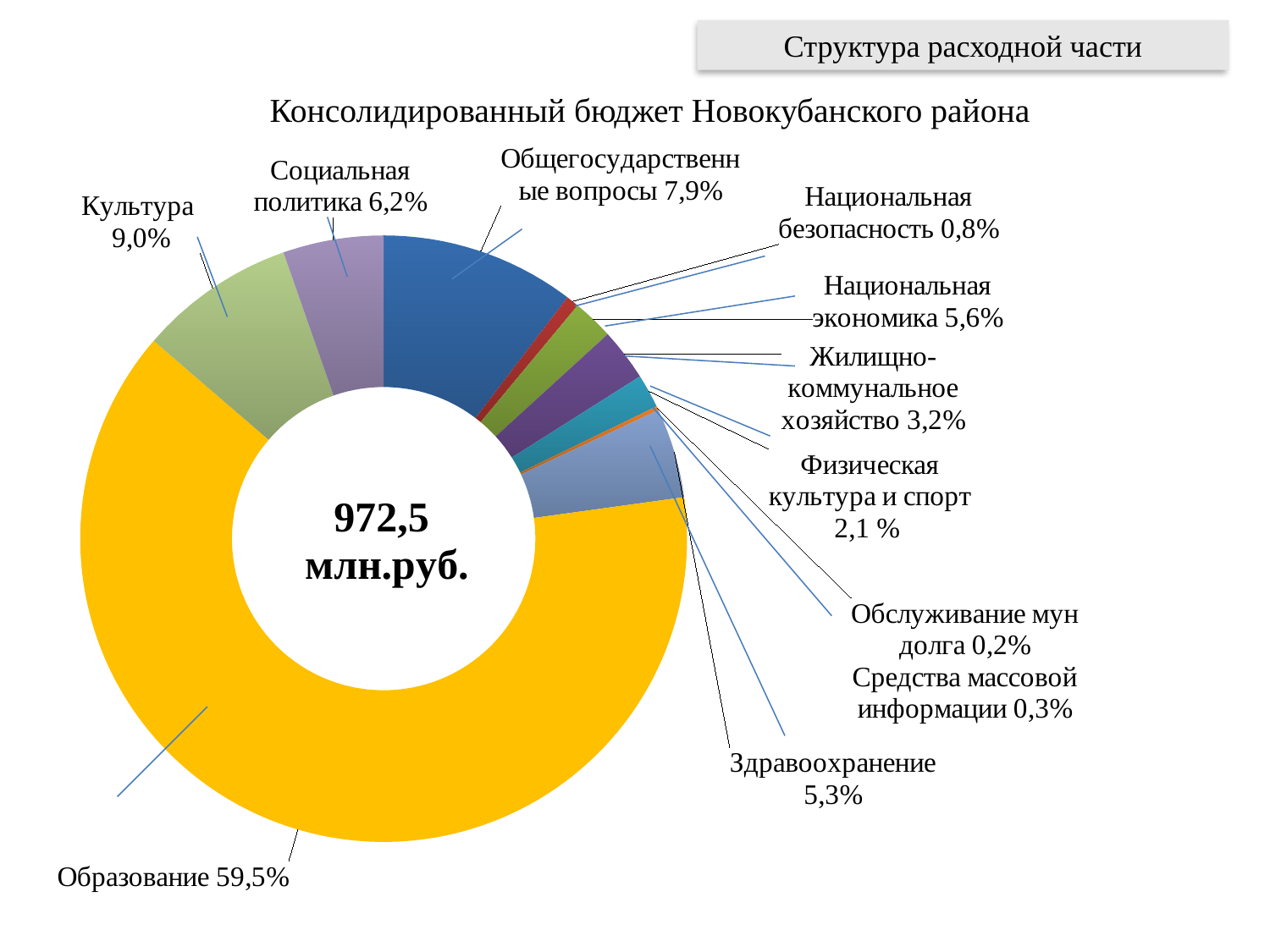
How many expenditure categories are shown in the chart? 11 What percentage is shown for Жилищно-коммунальное хозяйство? 3,2% What type of chart is used on the slide? Doughnut (pie) chart What is the title of the chart? Консолидированный бюджет Новокубанского района What total amount is shown in the centre of the chart? 972,5 млн.руб. What share is labelled for Здравоохранение? 5,3% What percentage is shown for Культура? 9,0% Which category has the largest share of the expenditure? Образование What share of the consolidated budget expenditure goes to Образование? 59,5% Which category has the smallest share of the expenditure? Обслуживание мун долга What is the difference in percentage points between Общегосударственные вопросы and Социальная политика? 1,7 Which has a larger share: Национальная экономика or Здравоохранение? Национальная экономика